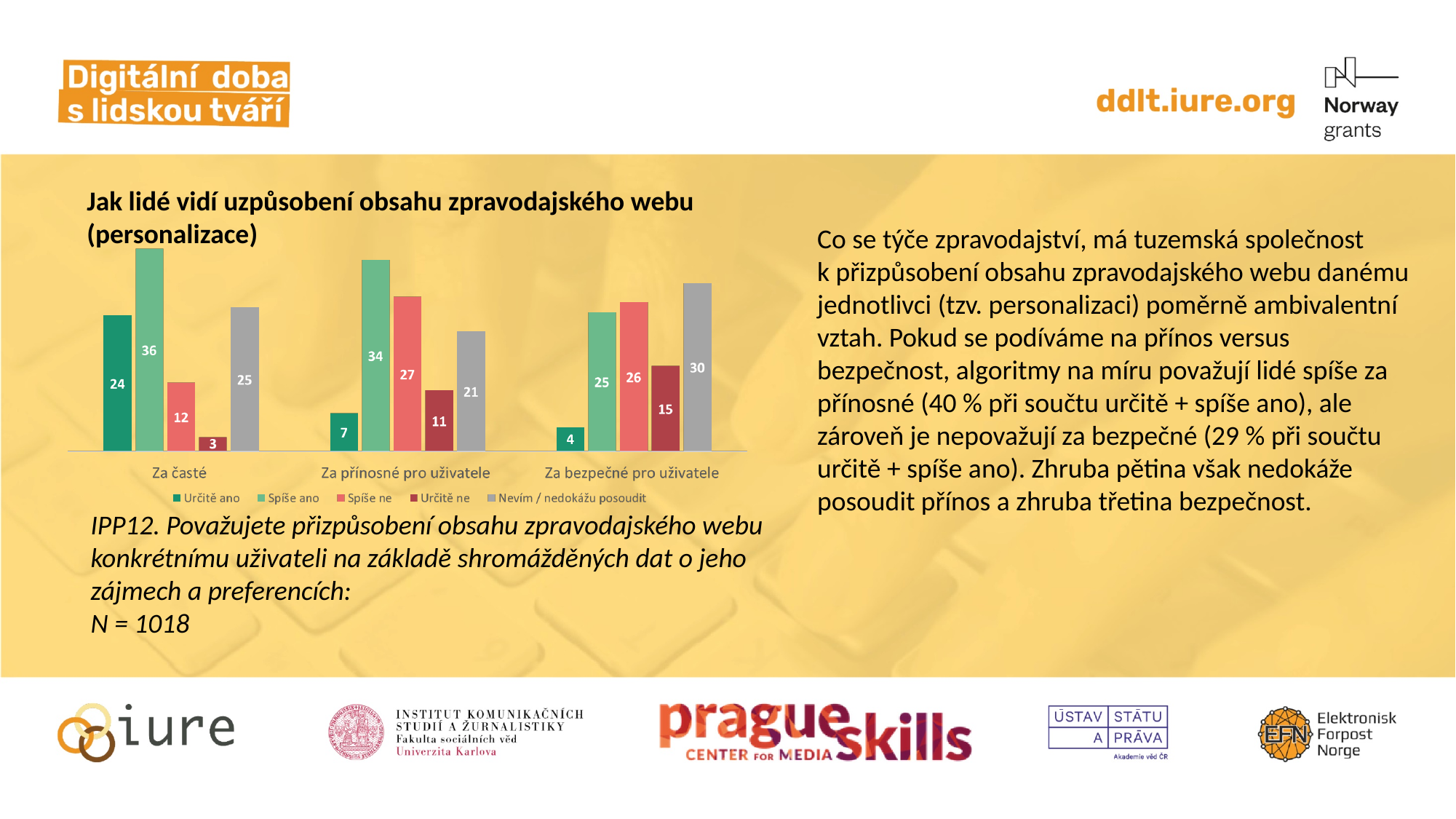
How many categories are shown on the x axis of the chart? 3 What is the title of the chart? Jak lidé vidí uzpůsobení obsahu zpravodajského webu (personalizace) Which is larger for "Určitě ano": the value for "Za časté" or the value for "Za bezpečné pro uživatele"? Za časté Which series has the highest value in the category "Za bezpečné pro uživatele"? Nevím / nedokážu posoudit Which series has the lowest value in the category "Za časté"? Určitě ne What type of chart is shown on the slide? bar chart What is the value of "Určitě ne" for the category "Za přínosné pro uživatele"? 11 How many series does the chart legend list? 5 What is the difference between "Spíše ano" and "Spíše ne" in the category "Za časté"? 24 What is the value of "Nevím / nedokážu posoudit" for the category "Za bezpečné pro uživatele"? 30 How does the value of "Určitě ano" change across the three categories from left to right? It falls What is the value of "Spíše ano" for the category "Za časté"? 36